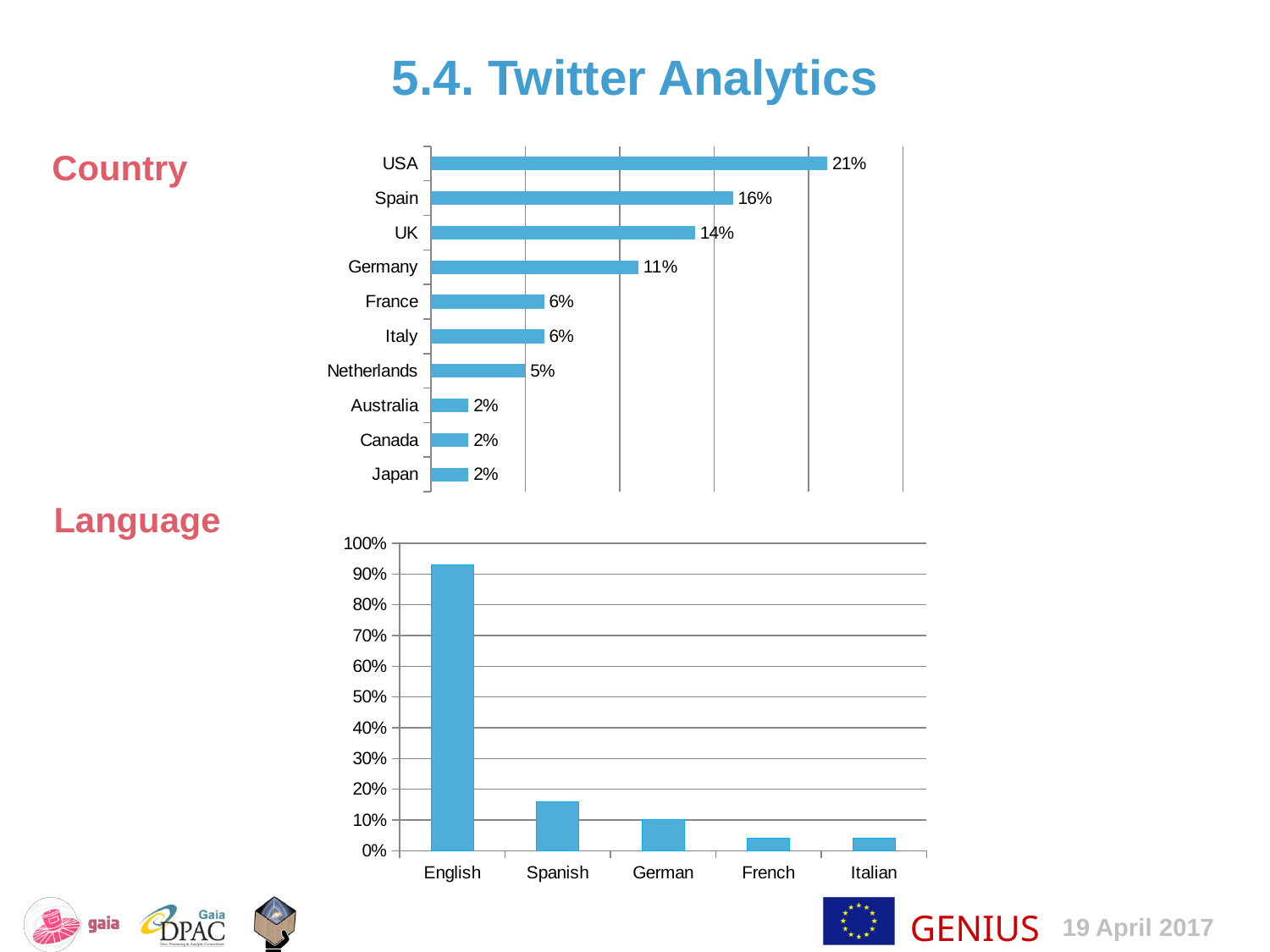
In the Country chart, what is the value for Netherlands? 5% In the Language chart, which language has the highest value? English In the Country chart, how many countries are shown? 10 In the Language chart, is the value for Spanish greater or less than 20%? less In the Language chart, how many languages are shown? 5 In the Country chart, which country has the highest value? USA What kind of chart is the Language chart? Bar chart In the Country chart, what is the difference between the values for USA and UK? 7% In the Country chart, what is the value for Germany? 11% In the Country chart, what is the value for Spain? 16% In the Country chart, which is larger, the value for France or the value for Netherlands? France In the Language chart, is the value for English greater or less than 90%? greater